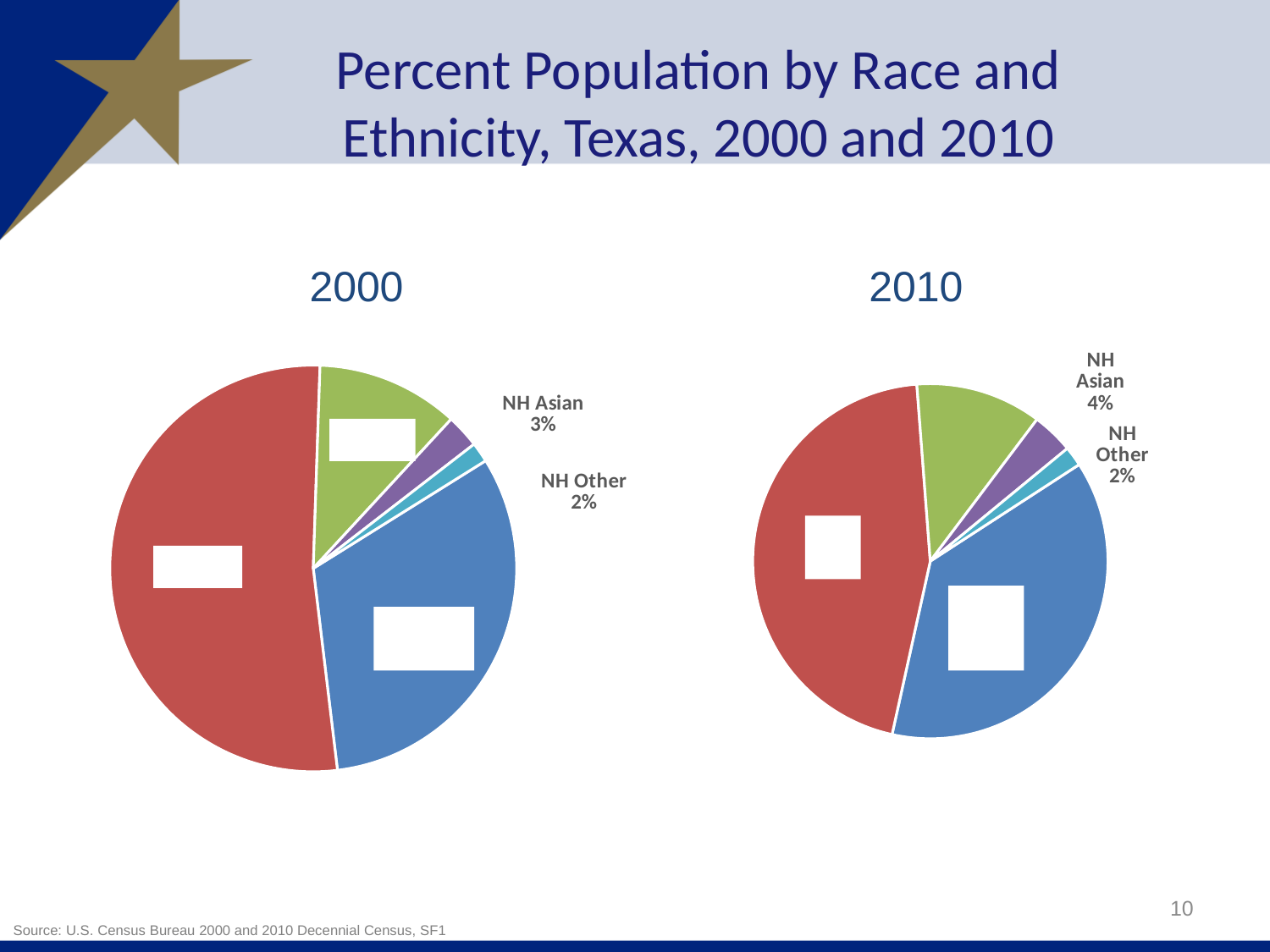
In the 2000 pie chart, what percentage is shown for NH Other? 2% How many slices does the 2000 pie chart have? 5 In the 2010 pie chart, what is the difference in percentage points between NH Asian and NH Other? 2 In the 2000 pie chart, what is the difference in percentage points between NH Asian and NH Other? 1 In the 2010 pie chart, which is larger, NH Asian or NH Other? NH Asian What is the title of the slide containing the two pie charts? Percent Population by Race and Ethnicity, Texas, 2000 and 2010 In the 2000 pie chart, what percentage is shown for NH Asian? 3% What kind of chart is used for the 2000 data on this slide? pie chart In the 2010 pie chart, which category has the smallest slice? NH Other Which chart shows a larger NH Asian share, 2000 or 2010? 2010 In the 2010 pie chart, what percentage is shown for NH Asian? 4% In the 2010 pie chart, what percentage is shown for NH Other? 2%